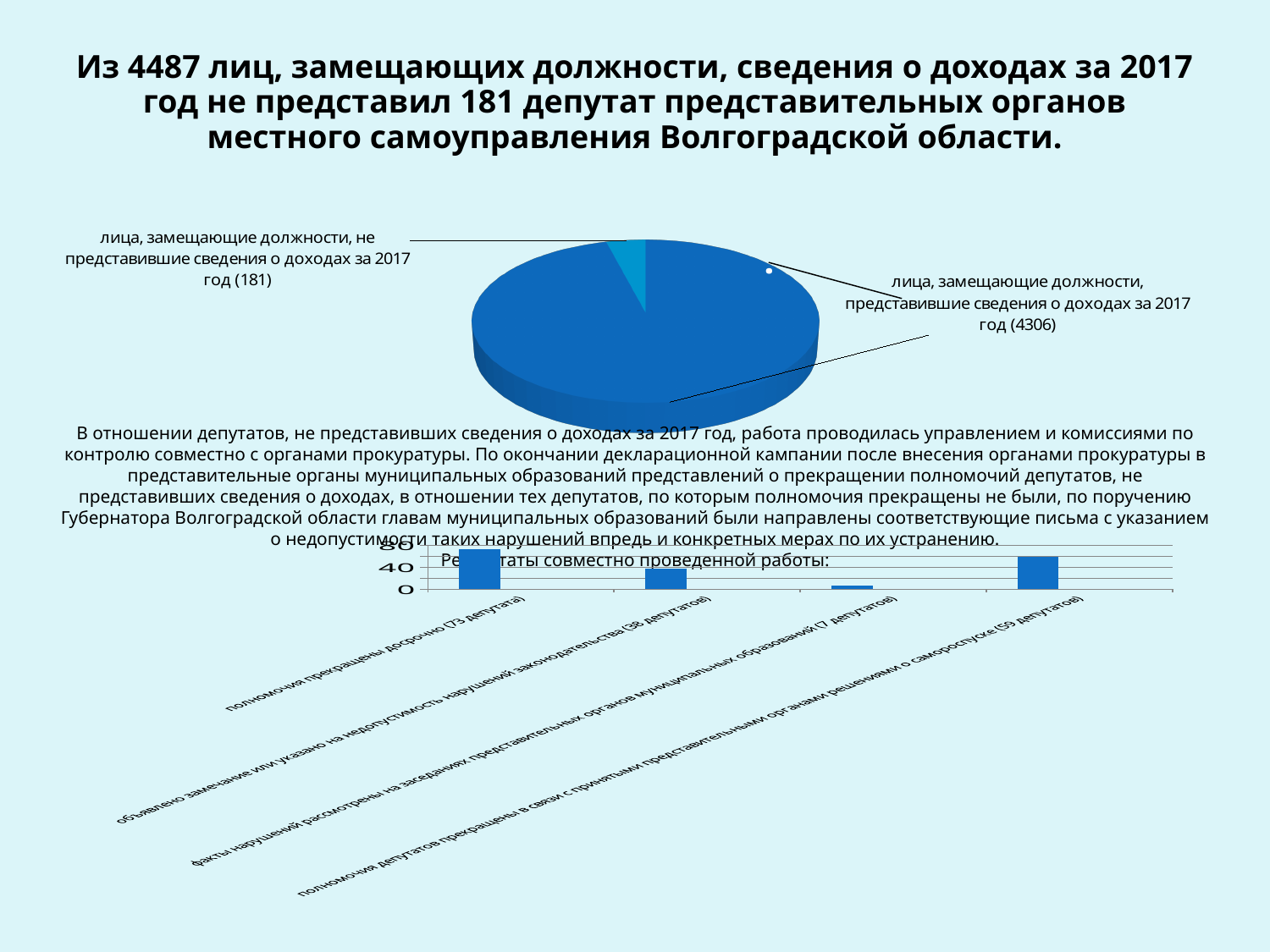
In the pie chart, how many persons holding positions did not submit income information for 2017? 181 How many slices does the pie chart at the top of the slide have? 2 In the pie chart, which slice is larger: persons who submitted income information or persons who did not? persons who submitted income information (4306) In the bar chart 'Результаты совместно проведенной работы', how many deputies had their powers terminated due to self-dissolution decisions (решениями о самороспуске)? 59 In the bar chart 'Результаты совместно проведенной работы', how many deputies had their powers terminated early (полномочия прекращены досрочно)? 73 What kind of chart is the chart at the bottom of the slide titled 'Результаты совместно проведенной работы'? bar chart In the bar chart 'Результаты совместно проведенной работы', which category has the highest value? полномочия прекращены досрочно (73 депутата) What kind of chart is the chart at the top of the slide? pie chart In the bar chart 'Результаты совместно проведенной работы', what is the difference between the number of deputies whose powers were terminated early (73) and those terminated by self-dissolution (59)? 14 In the pie chart, how many persons holding positions submitted income information for 2017? 4306 In the bar chart 'Результаты совместно проведенной работы', is the value for 'объявлено замечание или указано на недопустимость нарушений законодательства' greater or less than 40? less In the bar chart 'Результаты совместно проведенной работы', which category has the lowest value? факты нарушений рассмотрены на заседаниях представительных органов муниципальных образований (7 депутатов)